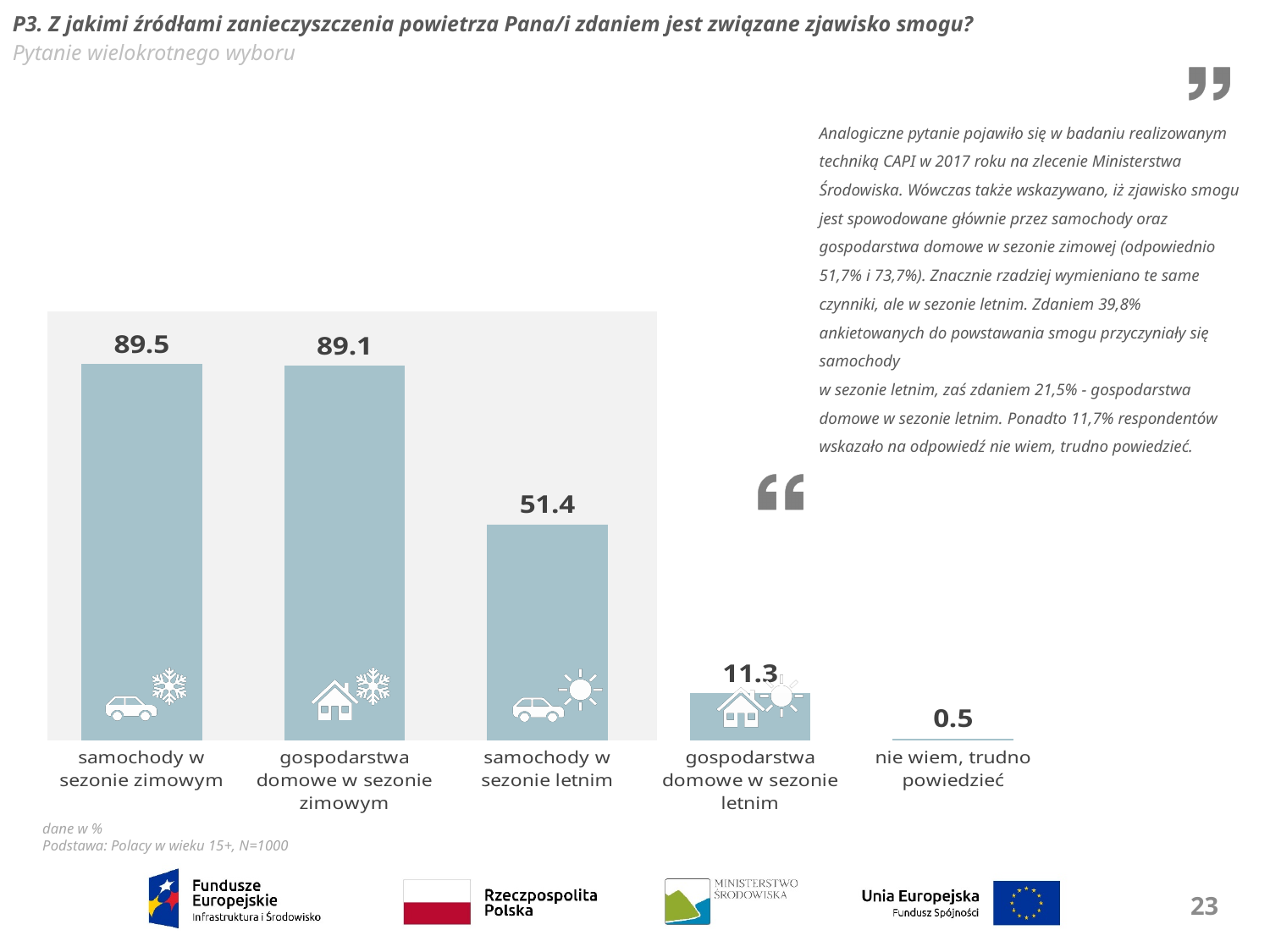
How many categories are shown in the chart? 5 What is the value for 'gospodarstwa domowe w sezonie letnim'? 11.3 What is the value for 'samochody w sezonie zimowym'? 89.5 What is the value for 'gospodarstwa domowe w sezonie zimowym'? 89.1 What is the value for 'nie wiem, trudno powiedzieć'? 0.5 What unit are the chart's data given in, according to the note below the chart? % What is the value for 'samochody w sezonie letnim'? 51.4 What is the difference between the values for 'samochody w sezonie zimowym' and 'samochody w sezonie letnim'? 38.1 Which is larger: the value for 'samochody w sezonie letnim' or 'gospodarstwa domowe w sezonie letnim'? samochody w sezonie letnim What kind of chart is shown on the slide? bar chart Which category has the highest value? samochody w sezonie zimowym Which category has the lowest value? nie wiem, trudno powiedzieć